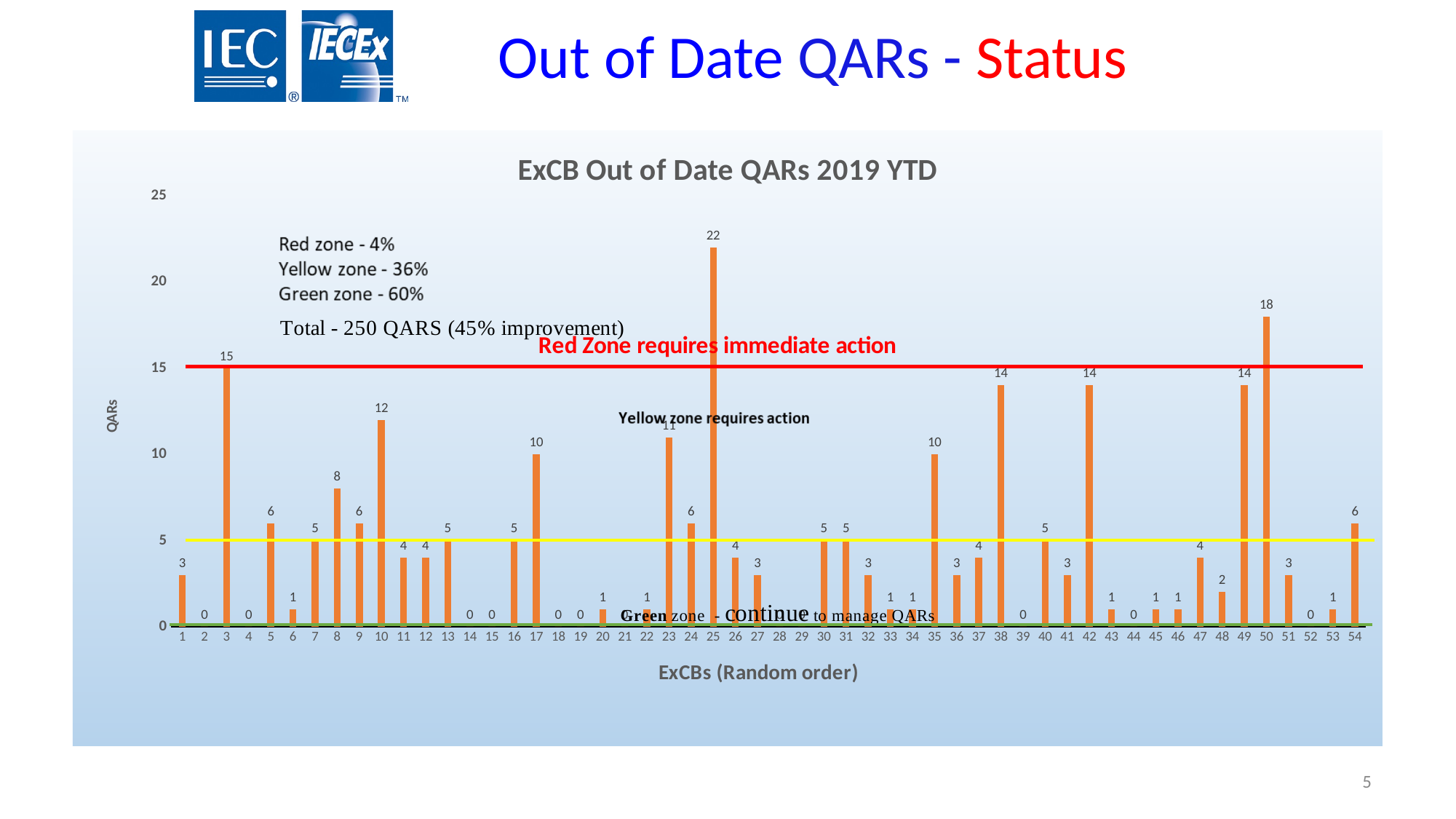
Which has a larger value, ExCB 17 or ExCB 23? ExCB 23 What is the title of the chart? ExCB Out of Date QARs 2019 YTD What is the difference between the values for ExCB 38 and ExCB 8? 6 How many ExCBs are plotted along the x axis? 54 What is the value for ExCB 25? 22 What is the value for ExCB 10? 12 What is the value for ExCB 3? 15 What type of chart is shown on the slide? Bar chart What is the value for ExCB 50? 18 Which ExCB has the highest number of out of date QARs? 25 What is the difference between the values for ExCB 25 and ExCB 50? 4 What is the x-axis title of the chart? ExCBs (Random order)